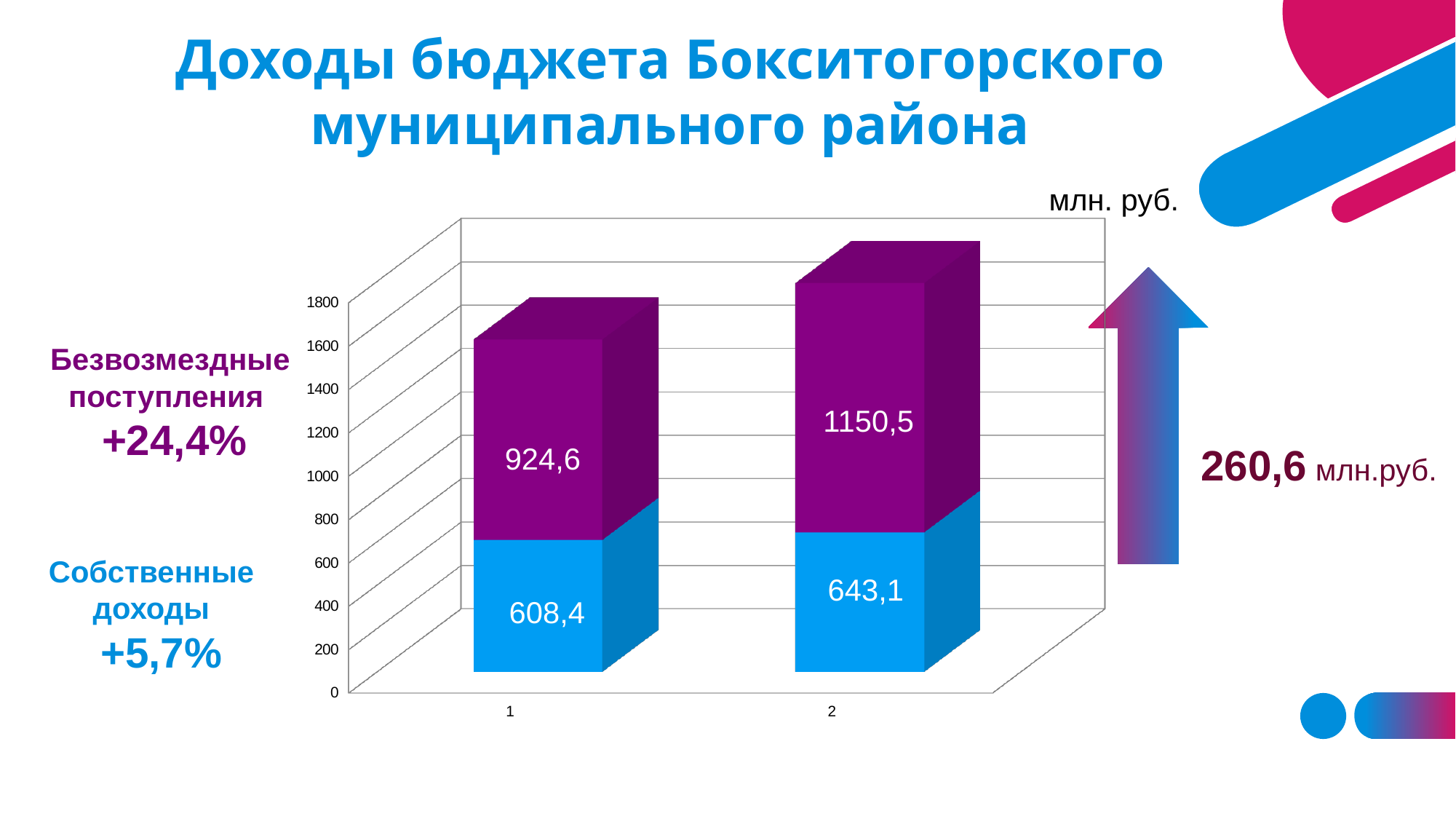
What unit is indicated for the values in the chart? млн. руб. Which category has the higher value for Собственные доходы, 1 or 2? 2 How many data series are plotted in the chart? 2 What is the value of Собственные доходы for category 1? 608,4 How many categories are shown on the x axis? 2 What is the value of Собственные доходы for category 2? 643,1 What is the difference between the Безвозмездные поступления values for category 2 and category 1? 225,9 What is the total of the stacked bar for category 1? 1533,0 What type of chart is shown on the slide? Stacked bar chart What is the value of Безвозмездные поступления for category 2? 1150,5 What is the total of the stacked bar for category 2? 1793,6 What is the value of Безвозмездные поступления for category 1? 924,6